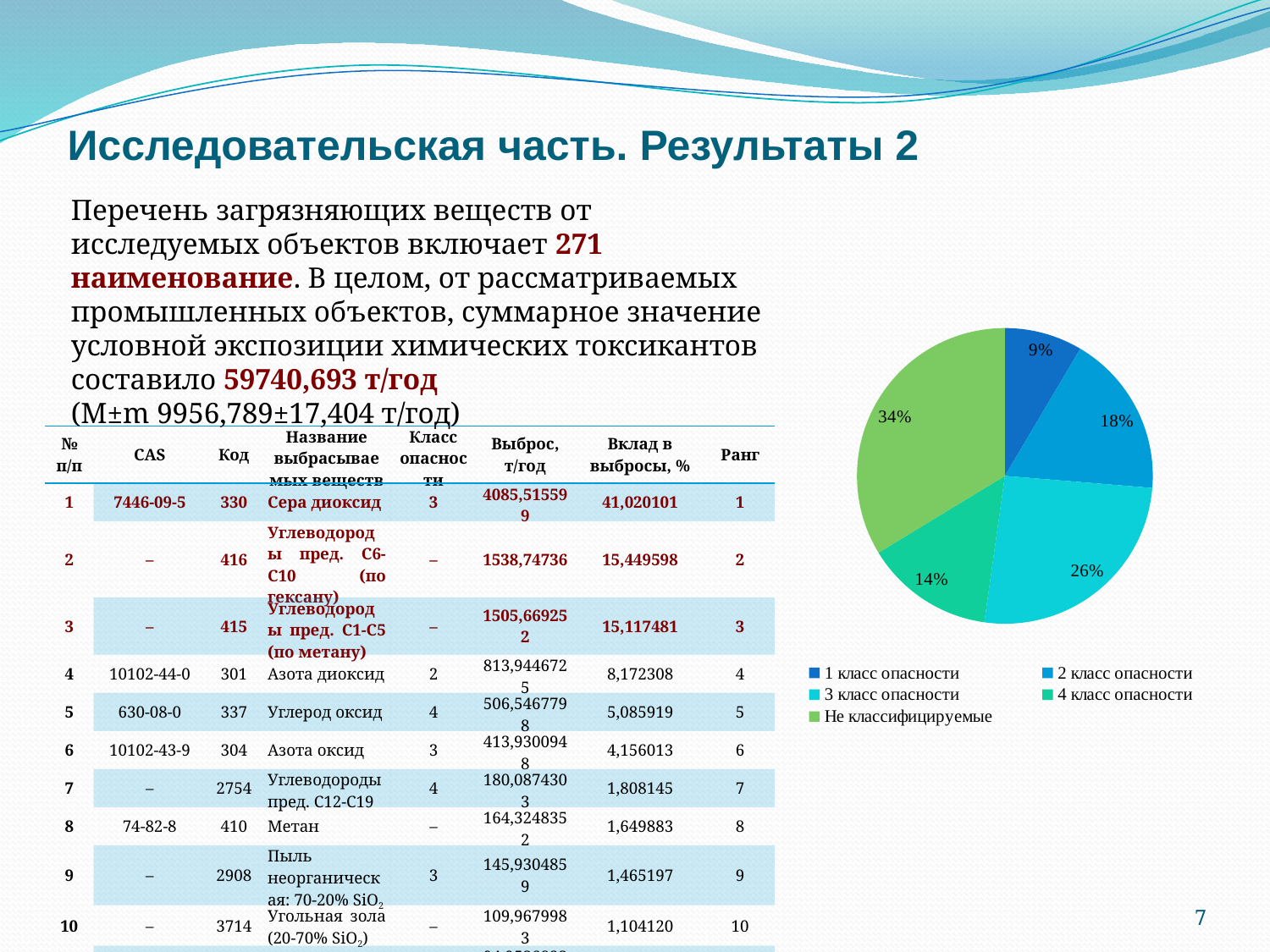
What share of the pie chart is labelled "Не классифицируемые"? 34% What kind of chart is shown on the slide? pie chart How many entries does the legend of the pie chart list? 5 Which category has the smallest slice in the pie chart? 1 класс опасности What share of the pie chart is labelled "4 класс опасности"? 14% What share of the pie chart is labelled "2 класс опасности"? 18% What is the difference in percentage points between the "3 класс опасности" slice and the "4 класс опасности" slice? 12 Which slice is larger in the pie chart: "2 класс опасности" or "4 класс опасности"? 2 класс опасности How many slices does the pie chart have? 5 Which category has the largest slice in the pie chart? Не классифицируемые